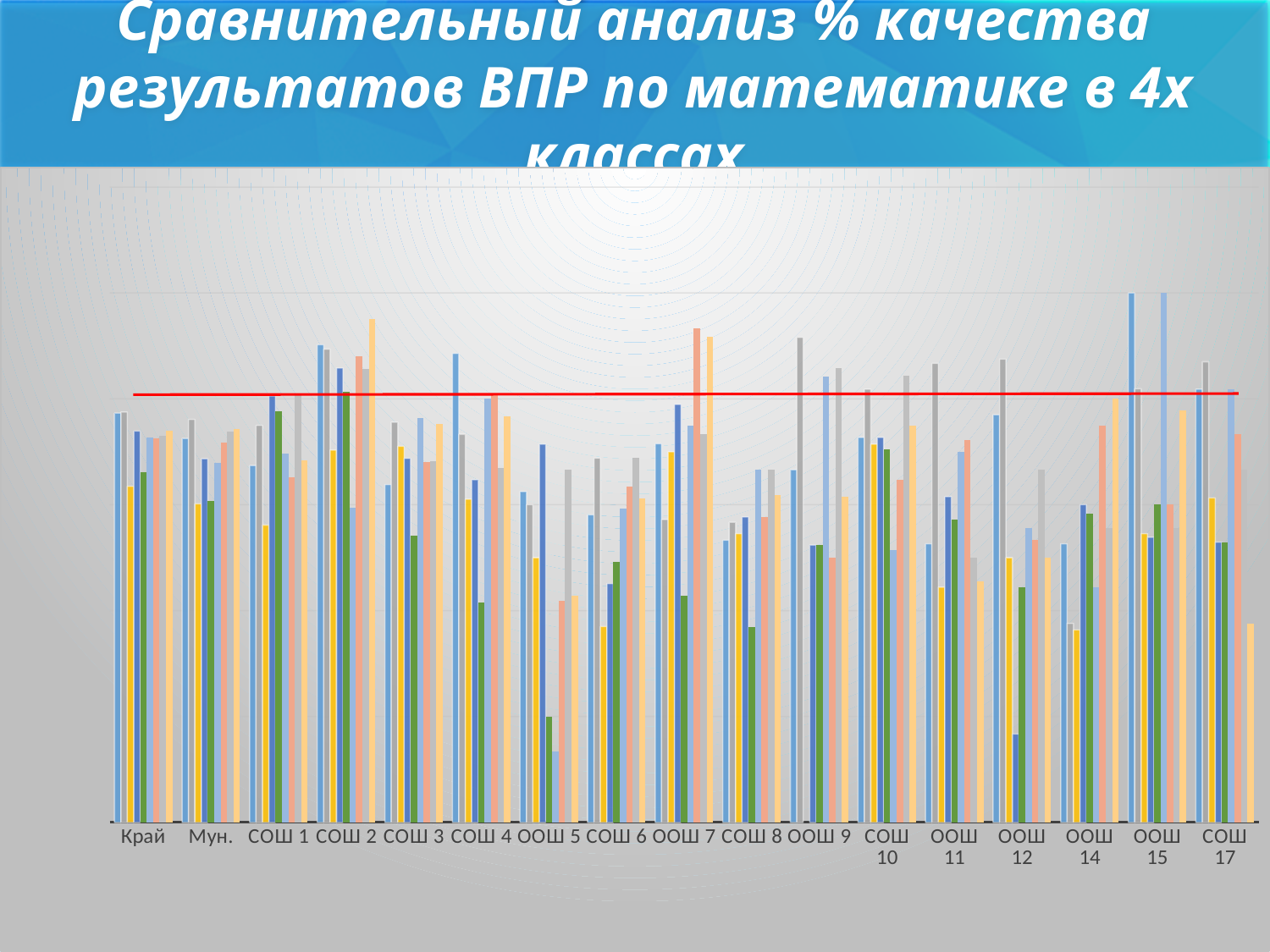
Which category contains the tallest bar in the chart? ООШ 15 What is the last category on the x axis of the chart? СОШ 17 What kind of chart is shown on the slide? bar chart How many categories on the x axis are labelled as СОШ? 8 How many categories on the x axis are labelled as ООШ? 7 How many categories are shown along the x axis of the chart? 17 What is the first category on the x axis of the chart? Край